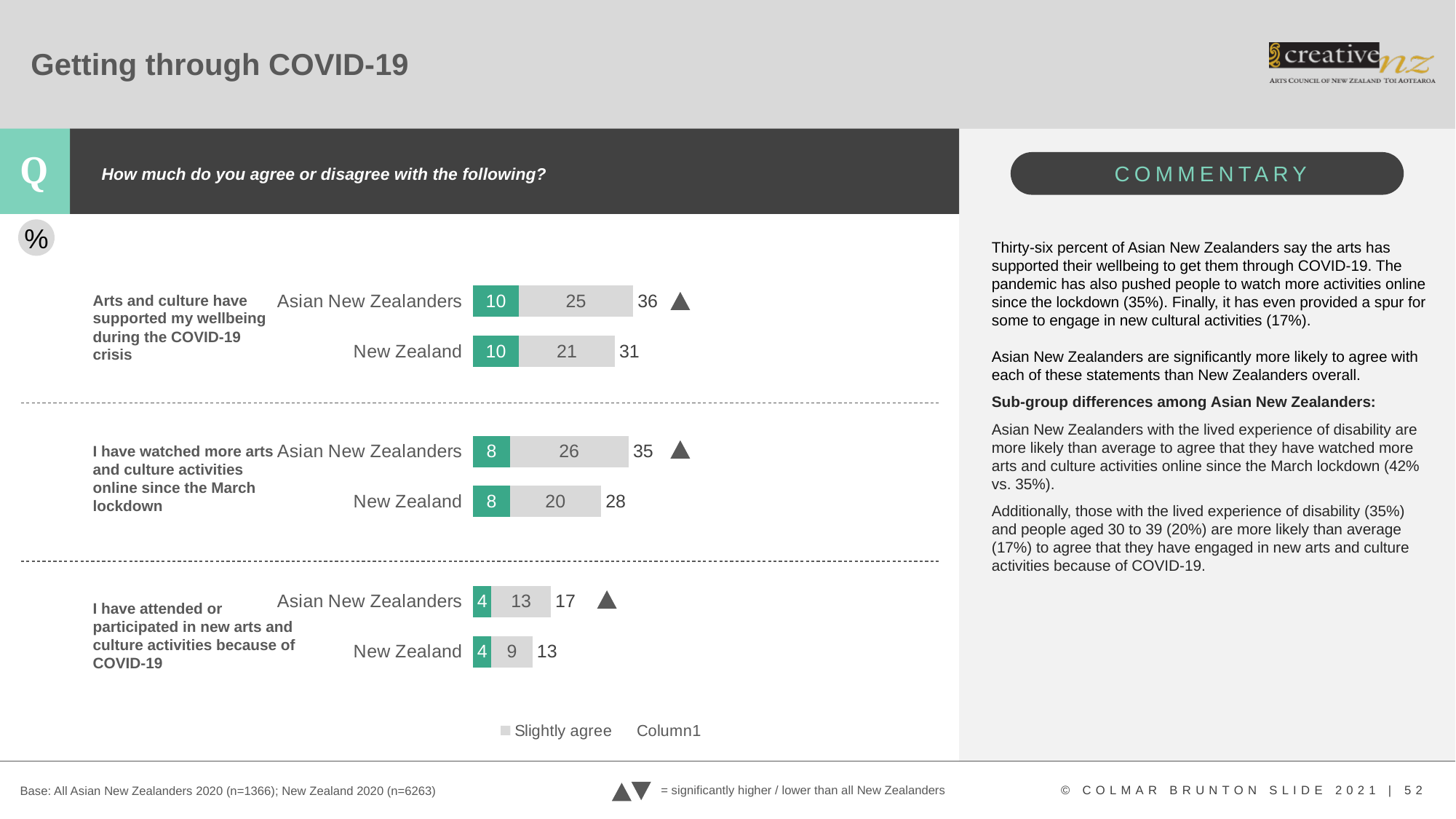
What is the 'Slightly agree' value for New Zealand on the statement 'I have watched more arts and culture activities online since the March lockdown'? 20 What is the difference between the 'Slightly agree' values for Asian New Zealanders and New Zealand on the statement 'I have attended or participated in new arts and culture activities because of COVID-19'? 4 What is the total agreement value shown for Asian New Zealanders on the statement 'Arts and culture have supported my wellbeing during the COVID-19 crisis'? 36 Which statement has the lowest total for New Zealand? I have attended or participated in new arts and culture activities because of COVID-19 How many statements are shown in the chart? 3 Which statement has the highest total for Asian New Zealanders? Arts and culture have supported my wellbeing during the COVID-19 crisis What is the total of the stacked bar for New Zealand on the statement 'I have watched more arts and culture activities online since the March lockdown'? 28 What entries does the chart legend list? Slightly agree, Column1 What is the difference between the total for Asian New Zealanders and the total for New Zealand on the statement 'Arts and culture have supported my wellbeing during the COVID-19 crisis'? 5 On the statement 'I have watched more arts and culture activities online since the March lockdown', which group has the larger total: Asian New Zealanders or New Zealand? Asian New Zealanders What kind of chart is shown on the slide? Bar chart What is the value of the green segment for Asian New Zealanders on the statement 'I have attended or participated in new arts and culture activities because of COVID-19'? 4